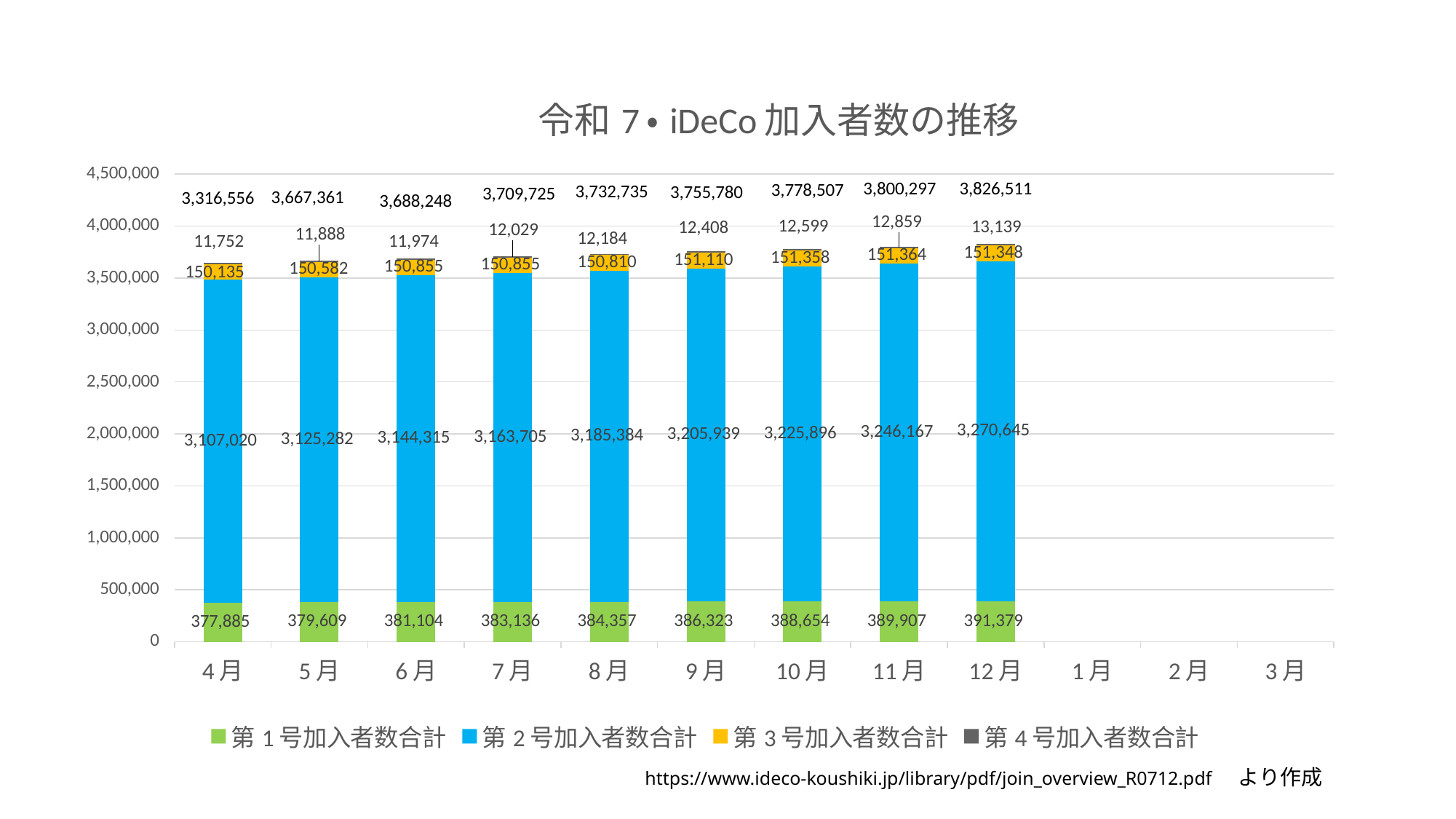
What is the difference between 第1号加入者数合計 in 12月 and in 4月? 13,494 What is the total of the stacked bar for 12月? 3,826,511 Which month has the lowest value for 第1号加入者数合計? 4月 What is the value of 第1号加入者数合計 for 4月? 377,885 How many months have bars plotted in the chart? 9 What is the value of 第4号加入者数合計 for 7月? 12,029 Which month has the highest value for 第2号加入者数合計? 12月 What is the value of 第3号加入者数合計 for 9月? 151,110 How many series does the legend list? 4 What kind of chart is shown on the slide? Stacked bar chart Does 第2号加入者数合計 rise or fall from 4月 to 12月? Rises What is the value of 第2号加入者数合計 for 12月? 3,270,645